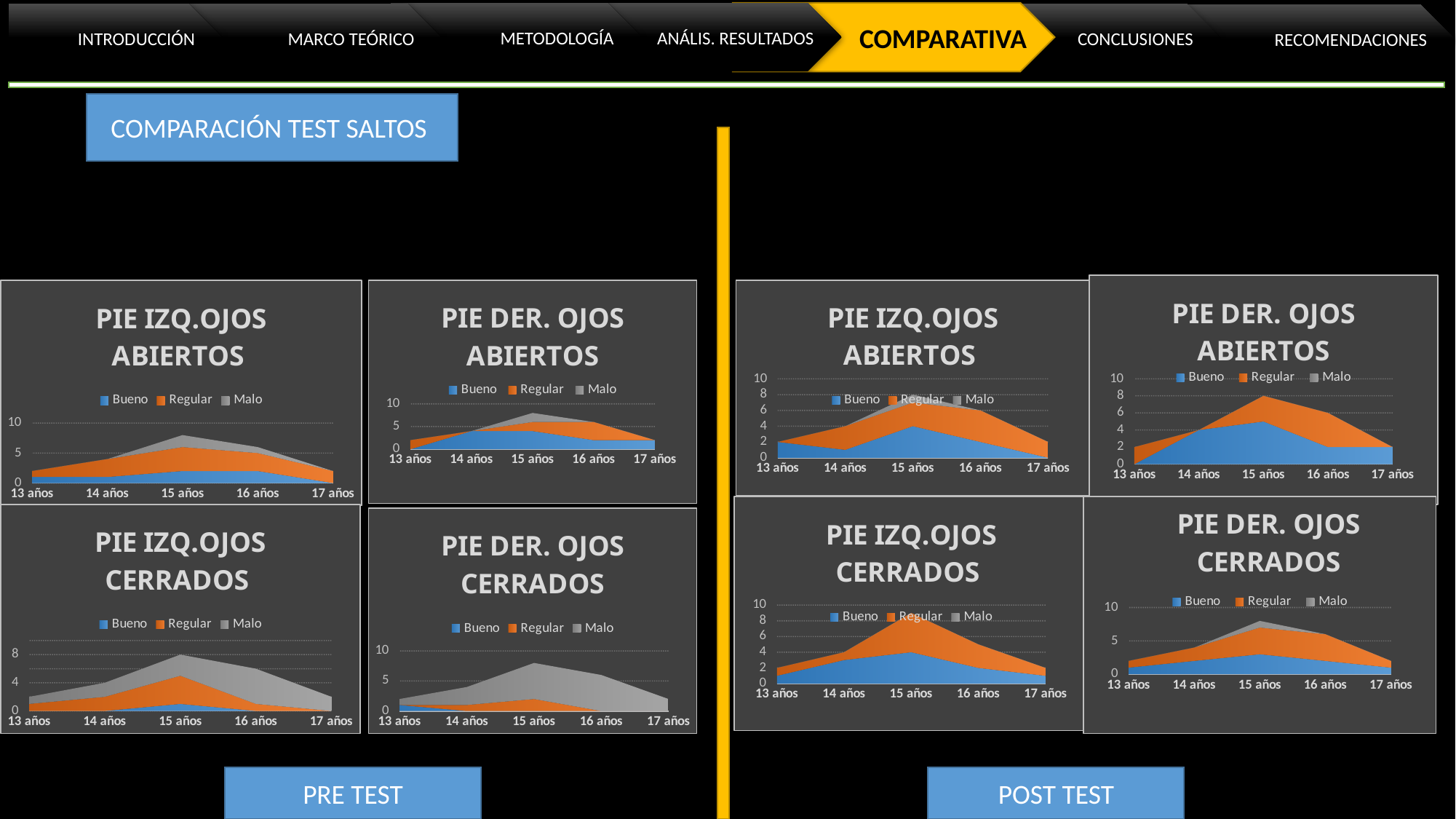
In the pre-test 'PIE IZQ.OJOS ABIERTOS' chart, which age group has the highest stacked total? 15 años In the post-test 'PIE DER. OJOS ABIERTOS' chart, is the stacked total for 13 años greater or less than 4? less In the pre-test 'PIE IZQ.OJOS ABIERTOS' chart, is the stacked total for 15 años greater or less than 5? greater What are the legend entries in the post-test 'PIE IZQ.OJOS CERRADOS' chart? Bueno, Regular, Malo In the pre-test 'PIE IZQ.OJOS ABIERTOS' chart, is the stacked total for 13 años greater or less than 5? less What kind of chart is the pre-test 'PIE IZQ.OJOS ABIERTOS' chart on the left side of the slide? Stacked area chart In the pre-test 'PIE IZQ.OJOS ABIERTOS' chart, does the stacked total rise or fall from 13 años to 15 años? rise In the post-test 'PIE IZQ.OJOS CERRADOS' chart, which age group has the highest stacked total? 15 años How many series does the legend list in the pre-test 'PIE DER. OJOS ABIERTOS' chart? 3 How many age categories are shown on the x axis of the pre-test 'PIE IZQ.OJOS CERRADOS' chart? 5 Which series is drawn in blue in the post-test 'PIE DER. OJOS CERRADOS' chart? Bueno